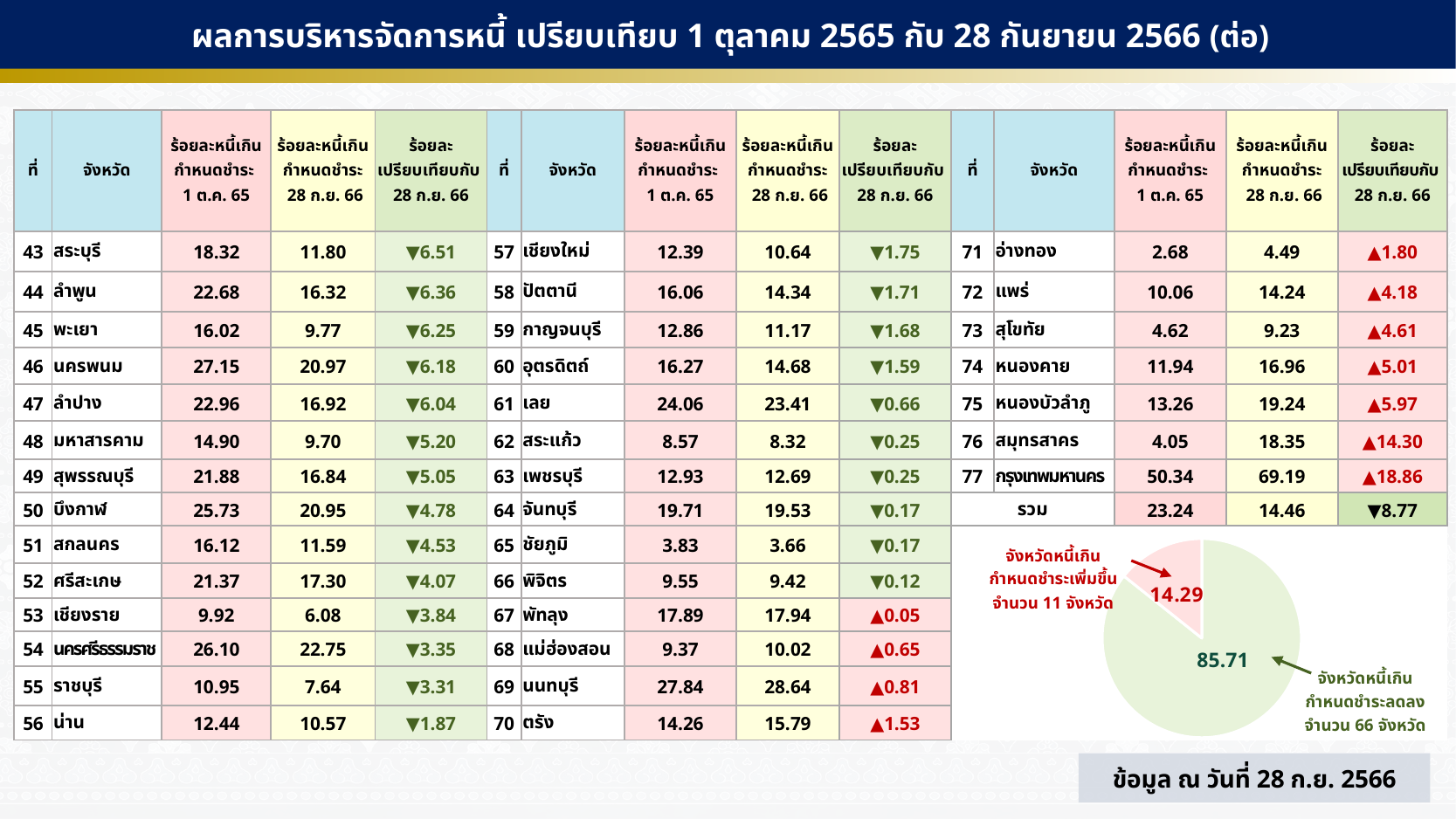
In the pie chart, what is the difference between the larger slice (85.71) and the smaller slice (14.29)? 71.42 How many slices does the pie chart have? 2 Which slice of the pie chart is the smallest? จังหวัดหนี้เกินกำหนดชำระเพิ่มขึ้น (14.29) According to the pie chart's label, how many provinces had decreased overdue debt? 66 จังหวัด What share of the pie chart does the slice for provinces with increased overdue debt represent? 14.29 What kind of chart is shown at the bottom right of the slide? Pie chart Which slice of the pie chart is the largest? จังหวัดหนี้เกินกำหนดชำระลดลง (85.71) According to the pie chart's label, how many provinces had increased overdue debt? 11 จังหวัด In the pie chart, what value is shown for the slice labelled จังหวัดหนี้เกินกำหนดชำระเพิ่มขึ้น (provinces with increased overdue debt)? 14.29 In the pie chart, is the slice for provinces with decreased overdue debt larger or smaller than the slice for provinces with increased overdue debt? Larger In the pie chart, what value is shown for the slice labelled จังหวัดหนี้เกินกำหนดชำระลดลง (provinces with decreased overdue debt)? 85.71